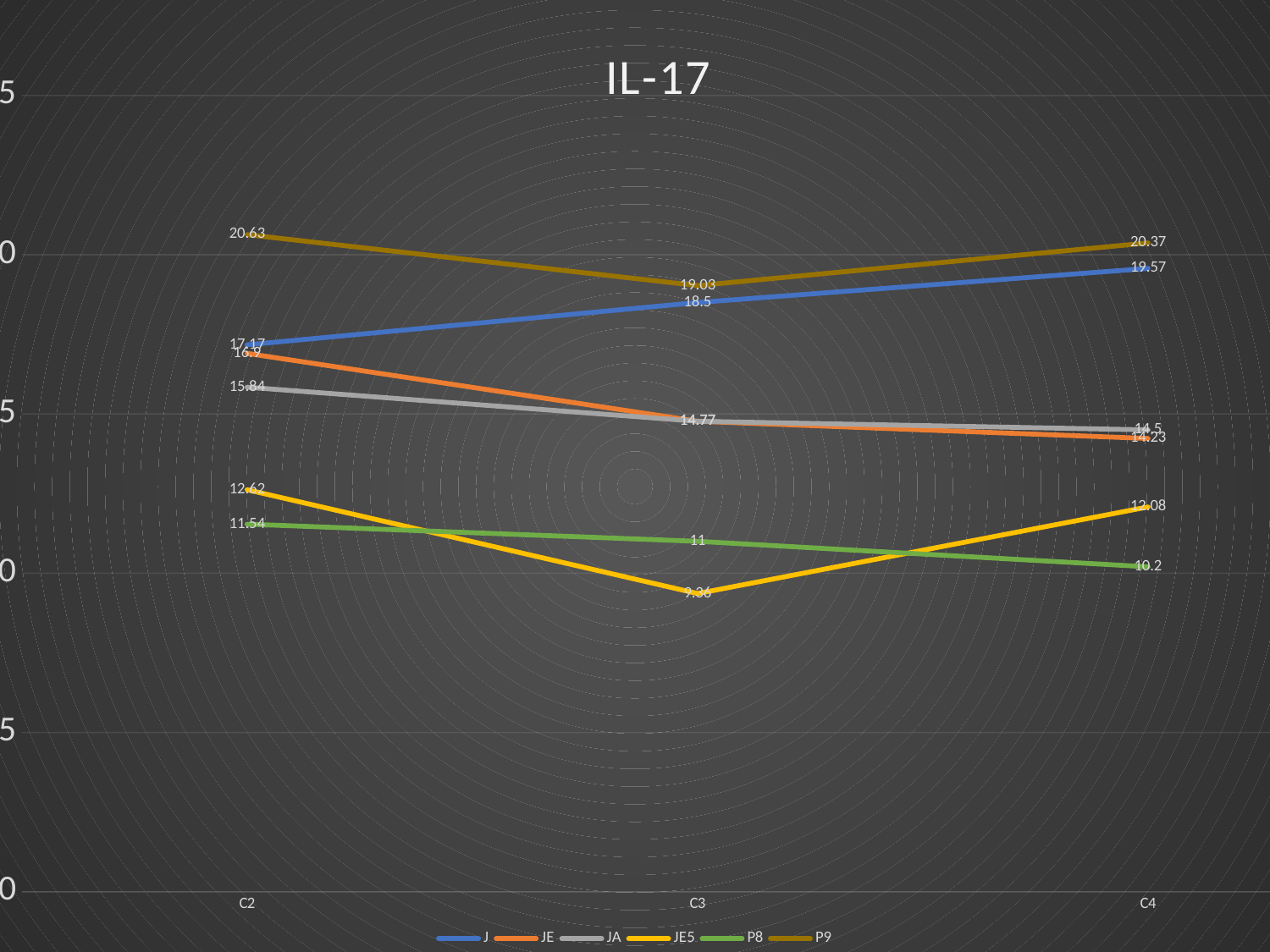
How many series does the legend list? 6 What kind of chart is shown on the slide? line chart Which series has the highest value at C2? P9 What is the value for J at C4? 19.57 What is the value for JE5 at C3? 9.36 How many categories are shown on the x axis? 3 What is the title of the chart? IL-17 Which series has the lowest value at C3? JE5 By how much does the value for J increase from C2 to C4? 2.4 What is the value for P9 at C2? 20.63 Does the value for J rise or fall from C2 to C4? rise What is the value for P8 at C4? 10.2